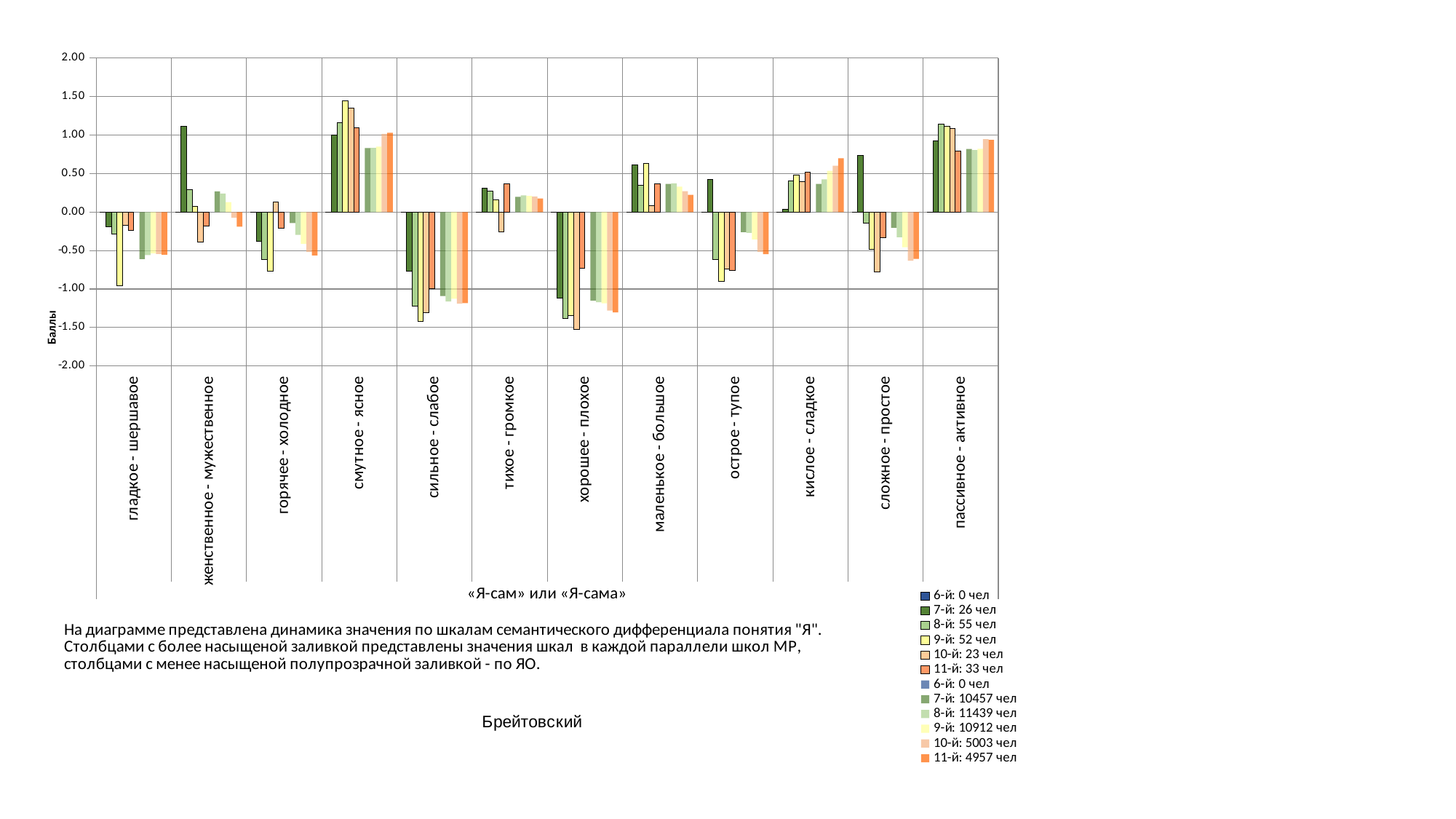
What kind of chart is shown on the slide? bar chart What is the label of the vertical axis of the chart? Баллы Is the value for "7-й: 26 чел" in the category "женственное - мужественное" greater or less than 1.00? greater Is the value for "7-й: 26 чел" in the category "пассивное - активное" greater or less than 0.50? greater Is the value for "9-й: 52 чел" in the category "смутное - ясное" greater or less than 1.00? greater In the category "смутное - ясное", which is larger: the value for "9-й: 52 чел" or the value for "7-й: 26 чел"? 9-й: 52 чел How many series does the chart's legend list? 12 In the category "женственное - мужественное", which is larger: the value for "7-й: 26 чел" or the value for "8-й: 55 чел"? 7-й: 26 чел How many categories (scales) are shown along the x axis of the chart? 12